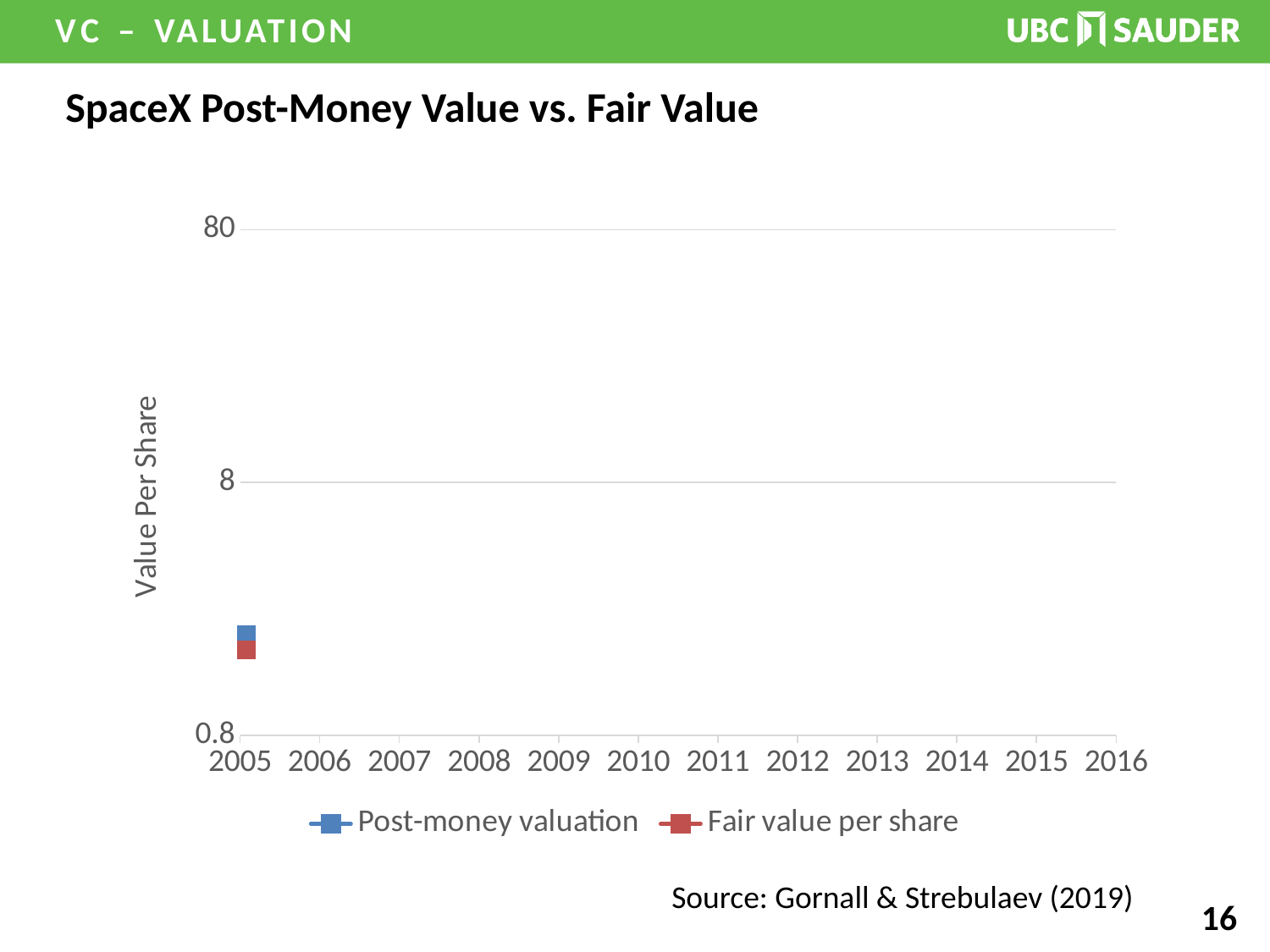
For which year are data points plotted on the chart? 2005 Is the Fair value per share value for 2005 greater or less than 8? less What are the two series named in the legend? Post-money valuation; Fair value per share In 2005, which is higher: the Post-money valuation or the Fair value per share? Post-money valuation Is the Post-money valuation value for 2005 greater or less than 0.8? greater How many years are labelled along the x axis? 12 Is the Post-money valuation value for 2005 greater or less than 8? less How many series does the legend list? 2 What kind of chart is shown on the slide? line chart What is the title of the chart? SpaceX Post-Money Value vs. Fair Value What is the highest value shown on the y axis? 80